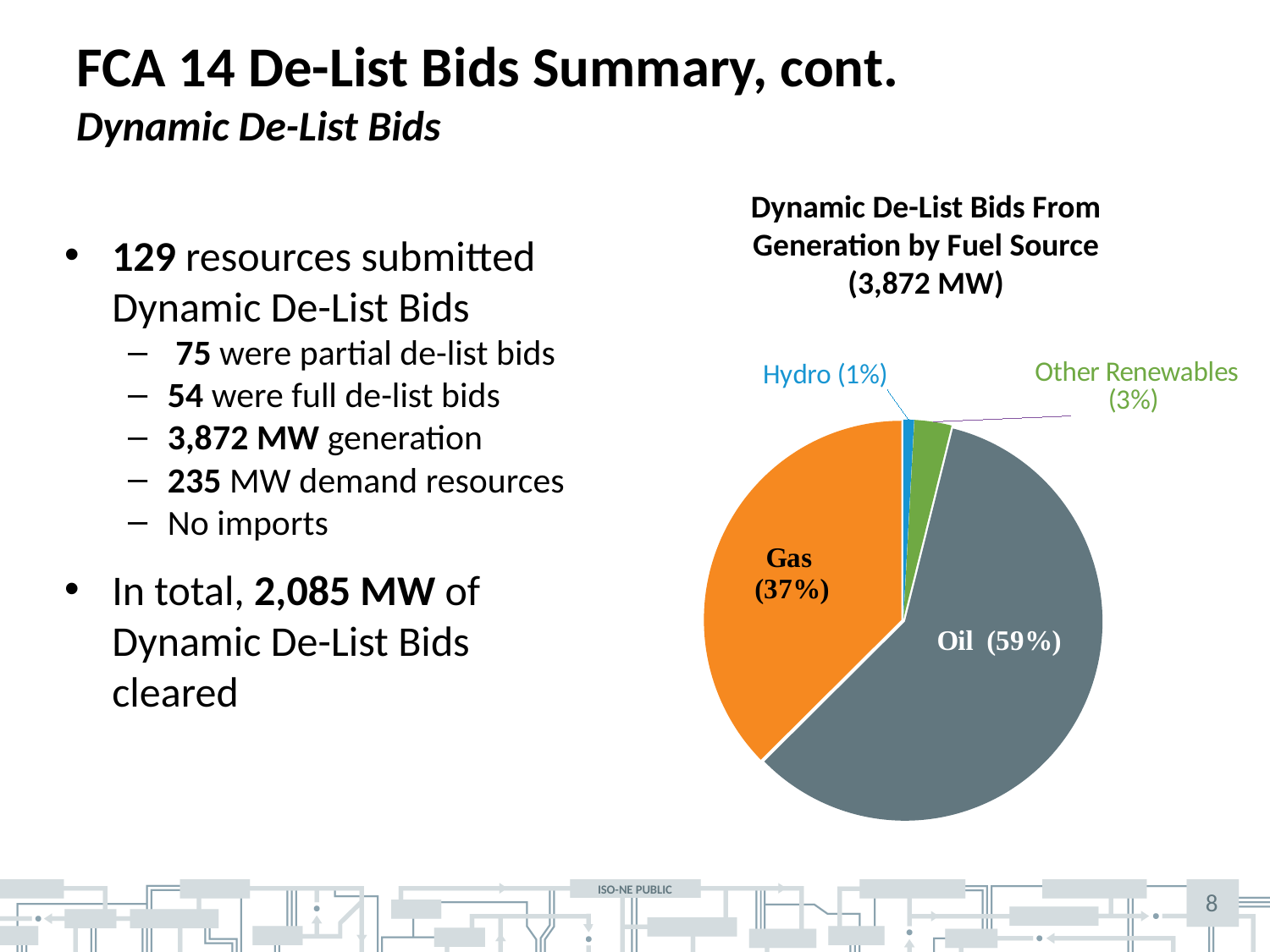
Which fuel source has the largest share of the pie? Oil What is the title of the chart? Dynamic De-List Bids From Generation by Fuel Source (3,872 MW) What share of the pie does Other Renewables represent? 3% What colour is the Gas slice of the pie? orange What type of chart is shown on the slide? pie chart What is the difference in percentage points between the Oil and Gas shares? 22 How many fuel source categories are shown in the pie chart? 4 What share of the pie does Gas represent? 37% What share of the pie does Oil represent? 59% Which fuel source has the smallest share of the pie? Hydro Which has a larger share, Other Renewables or Hydro? Other Renewables